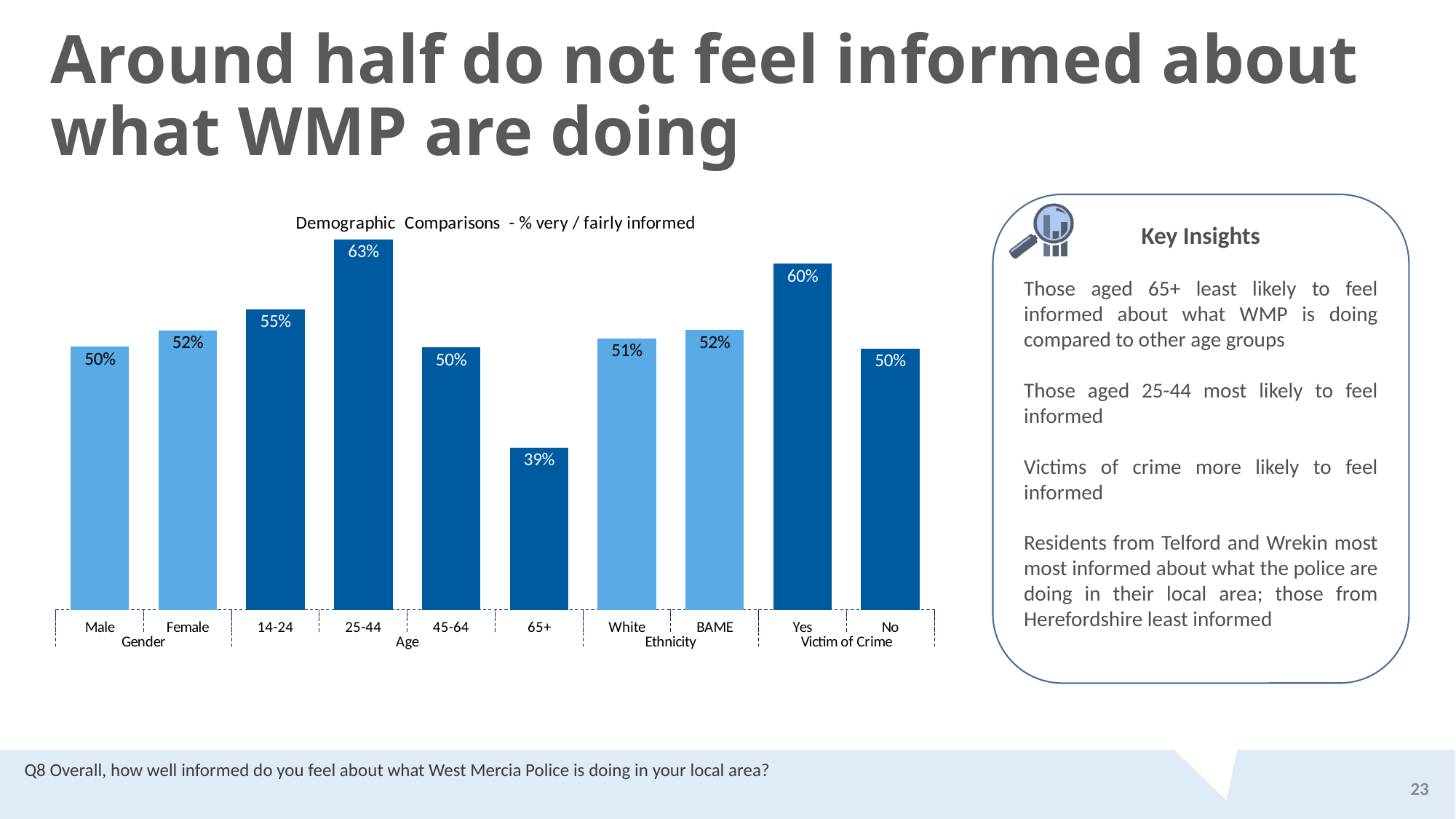
What is the value for the 25-44 age group? 63% What is the difference between the values for 25-44 and 65+? 24% What is the value for BAME? 52% What is the value for the 65+ age group? 39% Which category has the lowest value? 65+ What is the difference between the values for Yes and No under Victim of Crime? 10% How many bars are plotted in the chart? 10 Which category has the highest value? 25-44 Which is larger, the value for 14-24 or the value for 45-64? 14-24 What is the value for Female? 52% What kind of chart is shown on the slide? Bar chart What is the title of the chart? Demographic Comparisons - % very / fairly informed